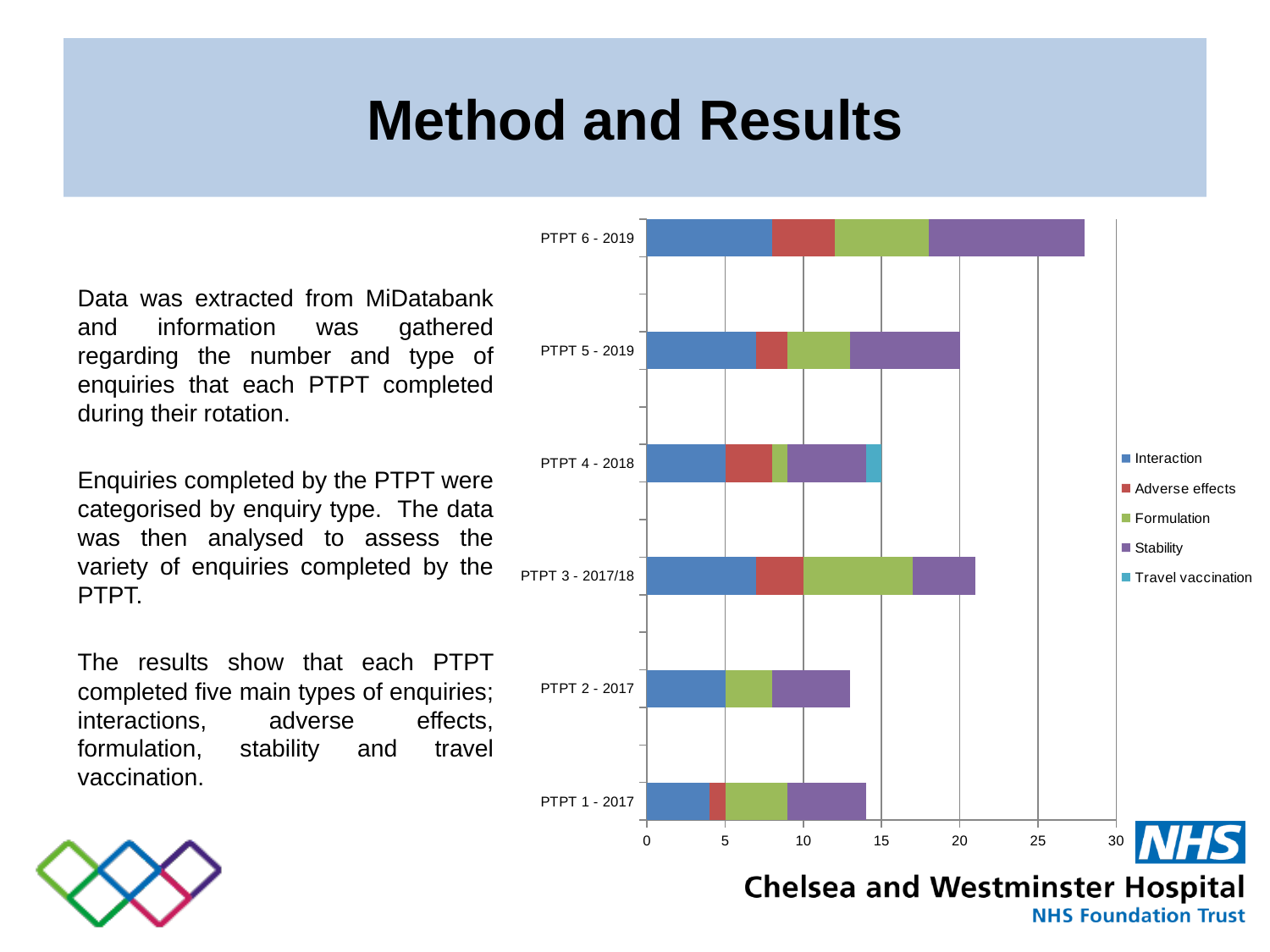
How many series does the chart legend list? 5 Is the total bar length for PTPT 2 - 2017 greater or less than 15? less Which PTPT has the longest bar (the most enquiries in total)? PTPT 6 - 2019 What kind of chart is shown on the slide? Stacked bar chart Is the total bar length for PTPT 1 - 2017 greater or less than 15? less Which PTPT is the only one with a Travel vaccination segment in its bar? PTPT 4 - 2018 Is the total bar length for PTPT 6 - 2019 greater or less than 25? greater How many PTPT categories are plotted on the chart? 6 Which series is shown in purple in the legend? Stability Which bar is longer, PTPT 6 - 2019 or PTPT 3 - 2017/18? PTPT 6 - 2019 Which bar is longer, PTPT 5 - 2019 or PTPT 2 - 2017? PTPT 5 - 2019